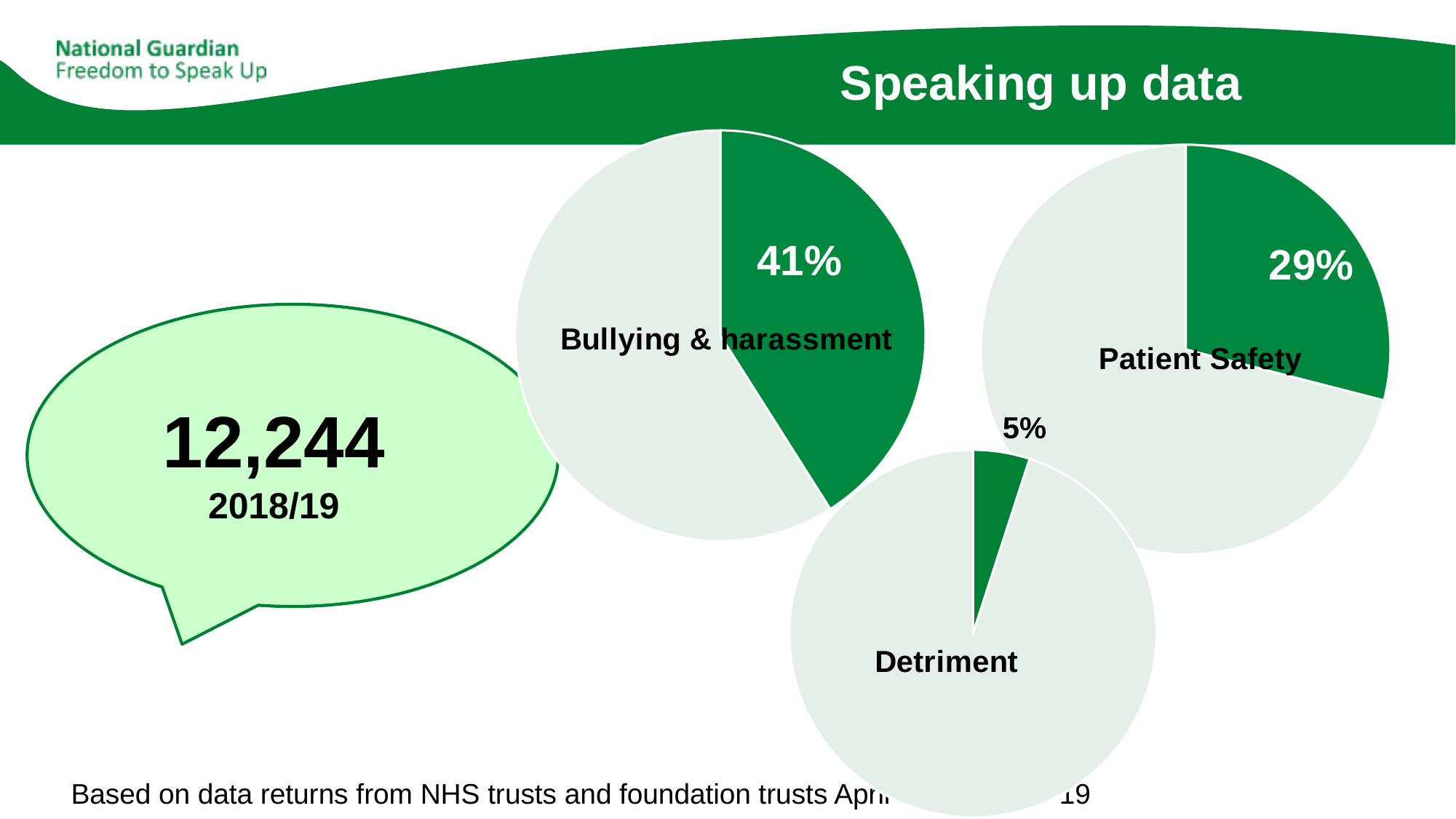
Across the three pie charts, which category has the smallest highlighted share? Detriment What is the difference between the Bullying & harassment percentage and the Patient Safety percentage? 12% How many pie charts are shown on the slide? 3 In the Patient Safety pie chart, what percentage is shown for the highlighted slice? 29% In the Bullying & harassment pie chart, what share of the pie is not highlighted in dark green? 59% Which is larger, the Patient Safety share or the Detriment share? Patient Safety Across the three pie charts, which category has the largest highlighted share? Bullying & harassment What kind of charts are used to show the Bullying & harassment, Patient Safety and Detriment figures? Pie charts In the Detriment pie chart, what percentage is shown for the highlighted slice? 5% What is the title of the slide containing the pie charts? Speaking up data What is the difference between the Patient Safety percentage and the Detriment percentage? 24% In the Bullying & harassment pie chart, what percentage is shown for the highlighted slice? 41%